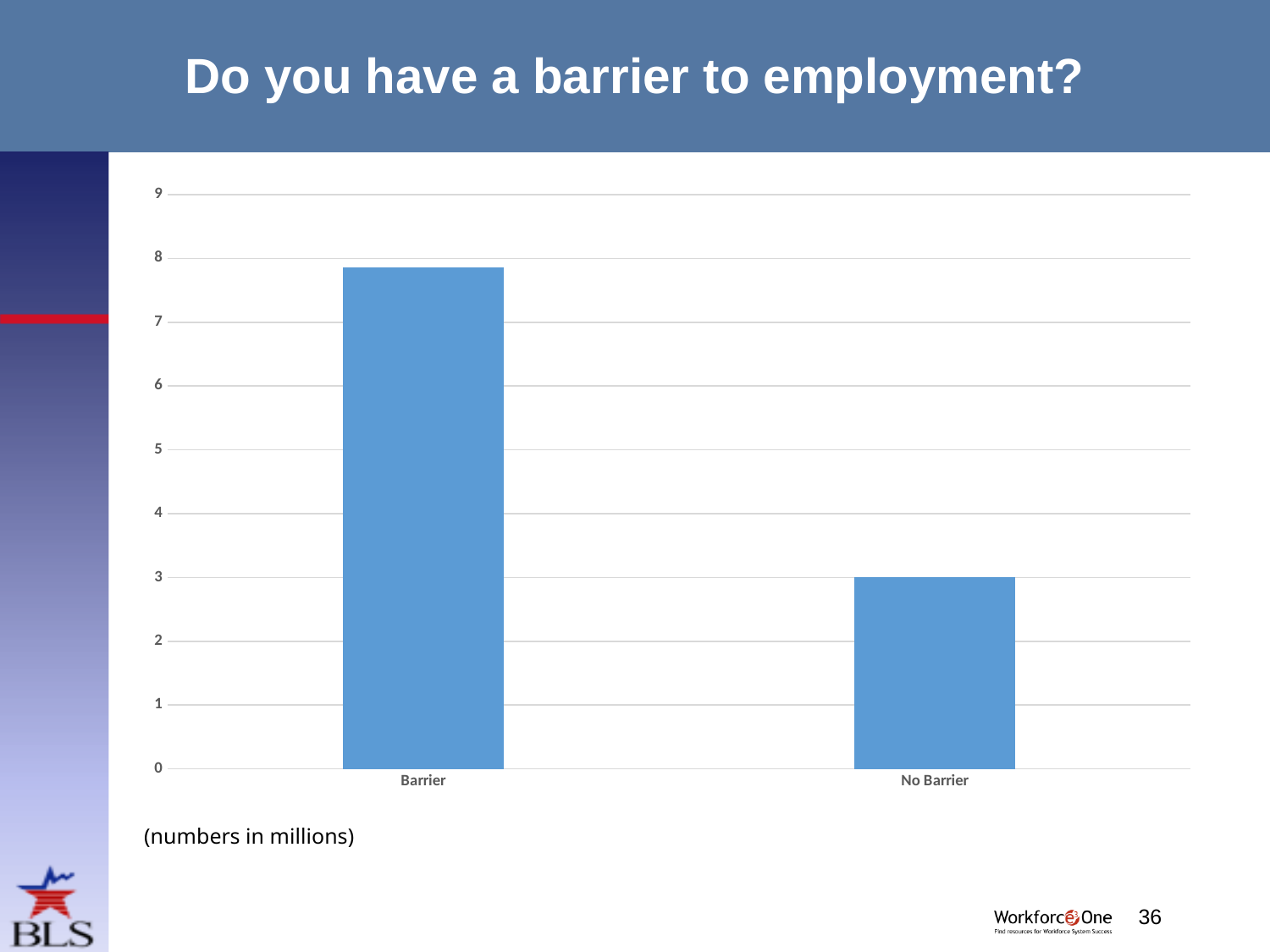
How many categories are shown on the x axis of the chart? 2 What is the highest value shown on the y axis of the chart? 9 Is the value for No Barrier greater or less than 4? less Which category has the highest bar in the chart? Barrier What is the title of the chart on the slide? Do you have a barrier to employment? What kind of chart is shown on the slide? bar chart Is the value for No Barrier greater or less than 2? greater Which category has the lowest bar in the chart? No Barrier Is the value for Barrier greater or less than 8? less Which is larger, the value for Barrier or the value for No Barrier? Barrier In what units are the chart's numbers expressed, according to the note below the chart? millions